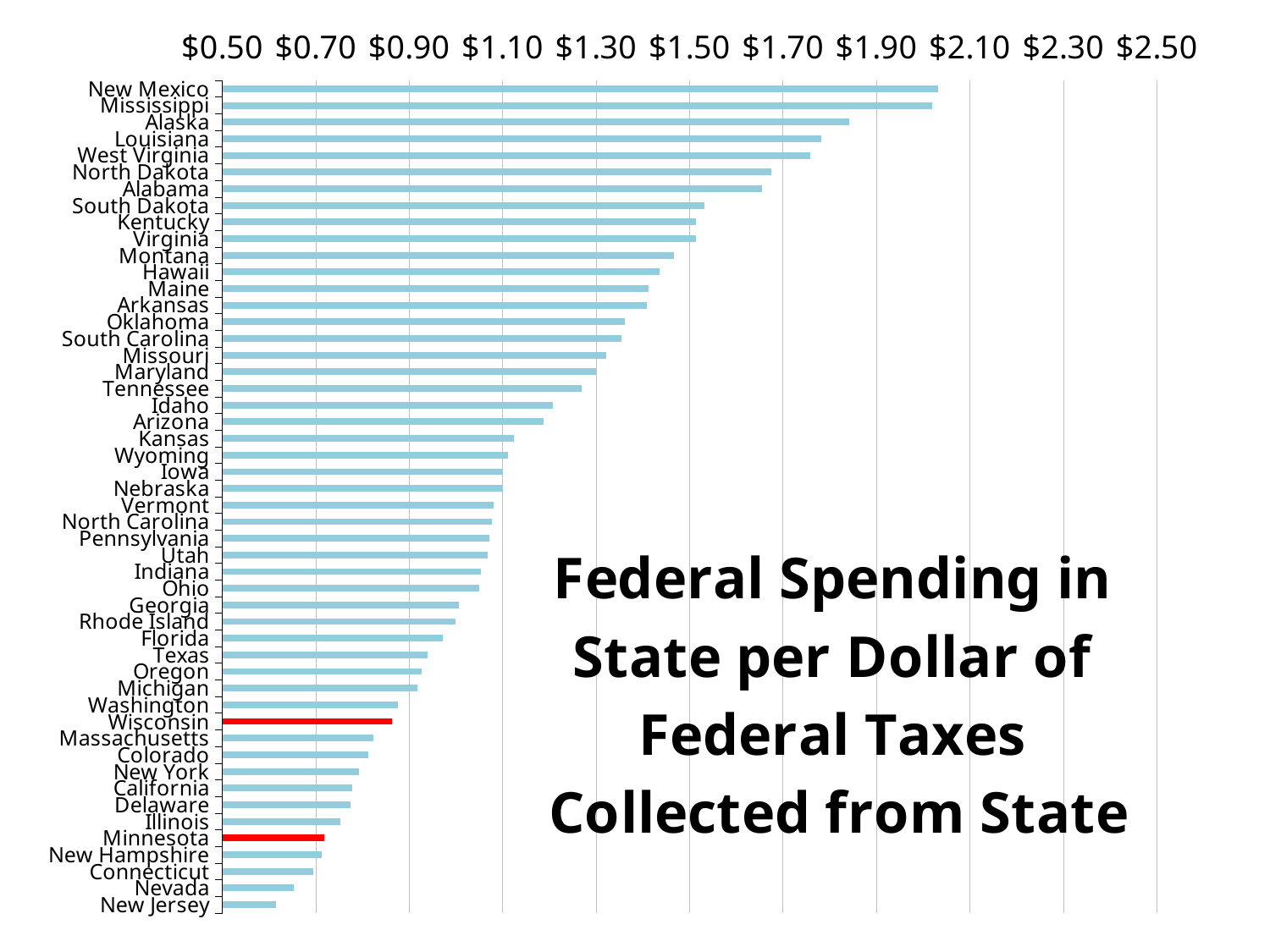
Is the value for New Jersey greater or less than $0.70? less Which state has the lowest federal spending per dollar of federal taxes collected? New Jersey How many states are plotted in the chart? 50 Which state has a larger value, Alaska or Hawaii? Alaska Is the value for Tennessee greater or less than $1.10? greater Is the value for Alaska greater or less than $1.70? greater Which state has the highest federal spending per dollar of federal taxes collected? New Mexico Do the bar values increase or decrease going from the top of the chart to the bottom? decrease Which two states are highlighted with red bars? Wisconsin and Minnesota What kind of chart is shown on the slide? bar chart